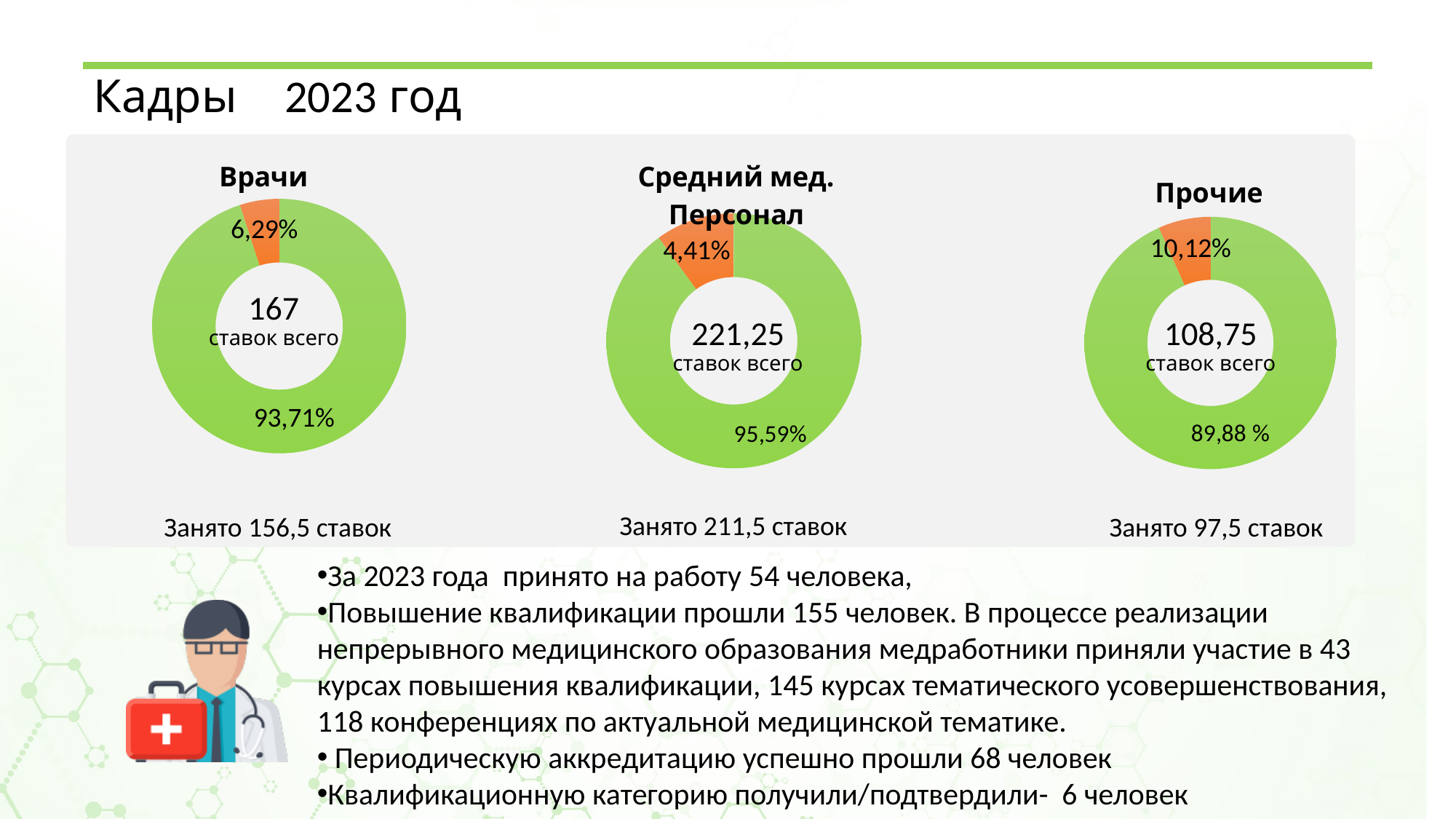
How many slices does the "Врачи" donut chart have? 2 What total number of positions (ставок всего) is shown in the centre of the "Средний мед. Персонал" chart? 221,25 What kind of chart is used for "Врачи"? Donut (pie) chart In the "Врачи" chart, what percentage does the green slice show? 93,71% In the "Прочие" chart, what percentage does the green slice show? 89,88 % In the "Врачи" chart, what percentage does the orange slice show? 6,29% In the "Прочие" chart, what percentage does the orange slice show? 10,12% In the "Средний мед. Персонал" chart, what percentage does the orange slice show? 4,41% What total number of positions (ставок всего) is shown in the centre of the "Прочие" chart? 108,75 In the "Средний мед. Персонал" chart, what percentage does the green slice show? 95,59%